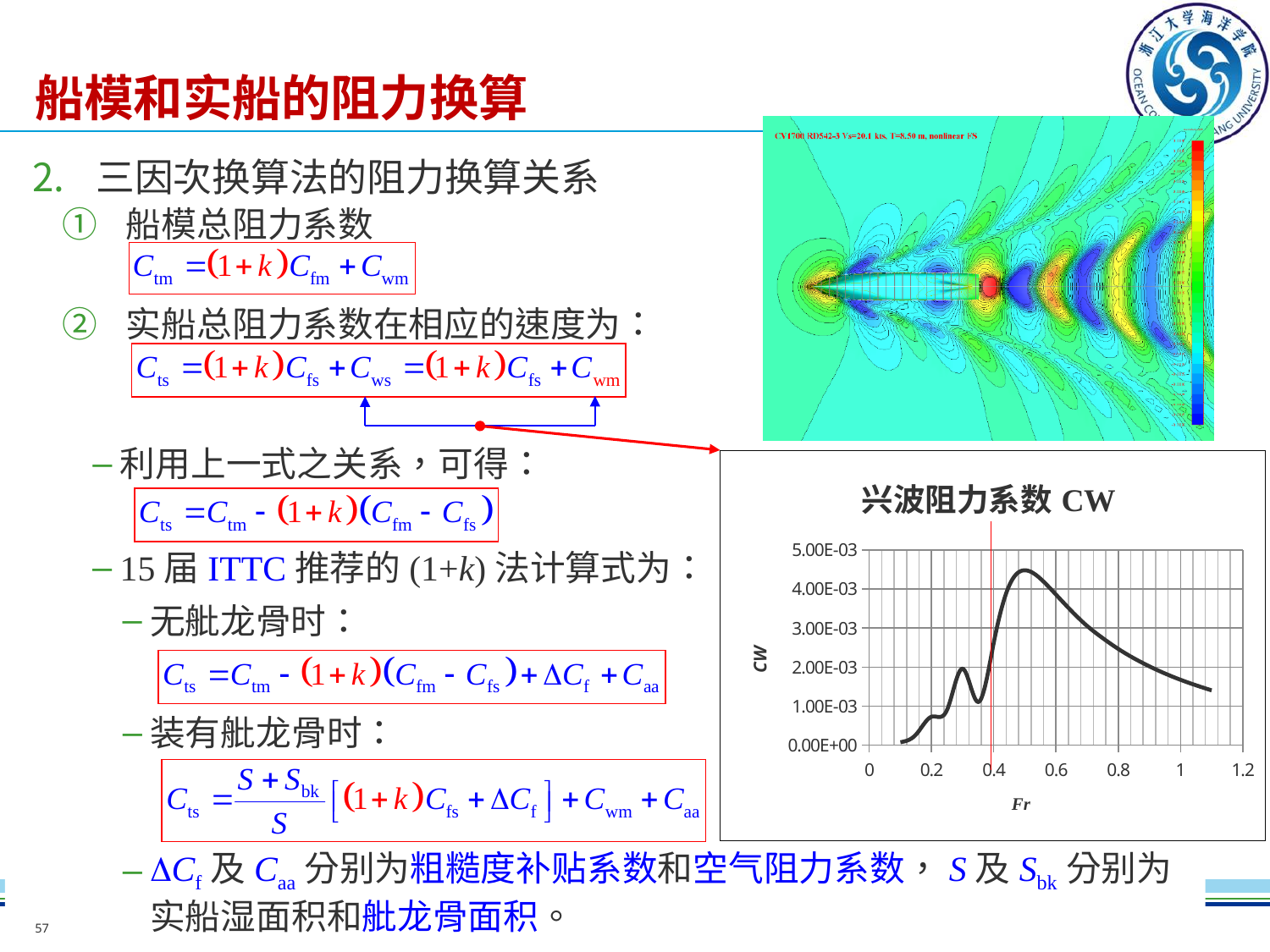
What is the title of the chart in the lower right of the slide? 兴波阻力系数 CW In the "兴波阻力系数 CW" chart, is the value of CW at Fr = 1.0 greater or less than 2.00E-03? less In the "兴波阻力系数 CW" chart, is the Fr value at which CW reaches its maximum greater or less than 0.4? greater In the "兴波阻力系数 CW" chart, what is the label of the x axis? Fr In the "兴波阻力系数 CW" chart, which is larger: the CW value at Fr = 0.5 or the CW value at Fr = 0.3? Fr = 0.5 In the "兴波阻力系数 CW" chart, is the value of CW at Fr = 0.2 greater or less than 1.00E-03? less In the "兴波阻力系数 CW" chart, do the CW values rise or fall as Fr increases from 0.4 to 0.5? rise In the "兴波阻力系数 CW" chart, do the CW values rise or fall as Fr increases from 0.6 to 1.1? fall What kind of chart is the "兴波阻力系数 CW" chart? line chart In the "兴波阻力系数 CW" chart, what is the highest tick value shown on the y axis? 5.00E-03